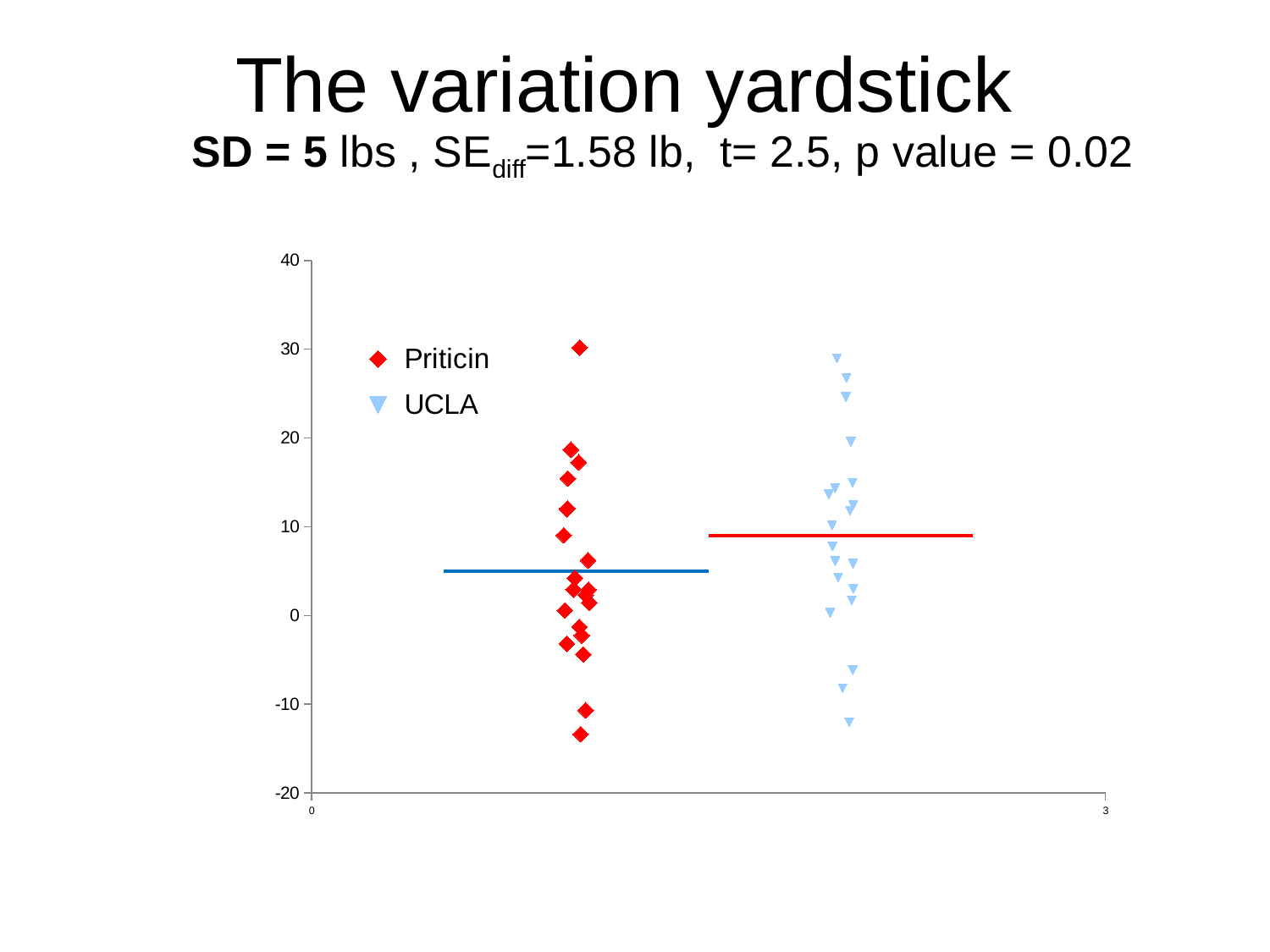
What is the highest value shown on the y axis? 40 Is the highest UCLA point greater or less than 20? greater Is the lowest Priticin point greater or less than -10? less Is the blue horizontal line through the Priticin points greater or less than 10? less What is the lowest value shown on the y axis? -20 What is the title of the slide containing the chart? The variation yardstick What kind of chart is shown on the slide? scatter chart How many series does the legend list? 2